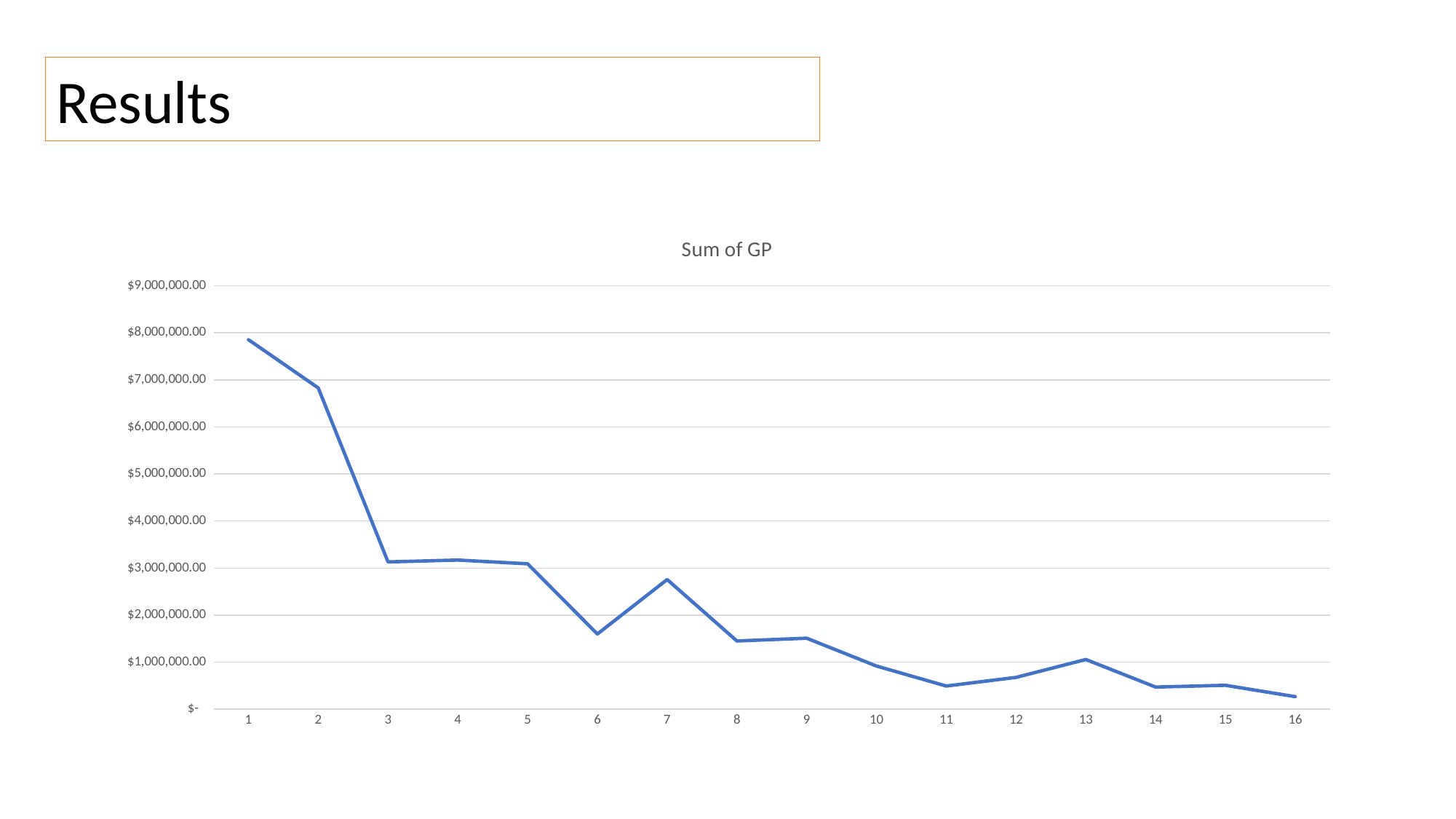
Which has a larger Sum of GP, category 6 or category 7? 7 Is the value for category 1 greater or less than $7,000,000.00? greater How many points are plotted along the x axis of the chart? 16 Which x-axis category has the highest Sum of GP? 1 Which x-axis category has the lowest Sum of GP? 16 Is the value for category 7 greater or less than $2,000,000.00? greater What is the title of the chart? Sum of GP Is the value for category 2 greater or less than $7,000,000.00? less What type of chart is shown on the slide? line chart Overall, do the values rise or fall from category 1 to category 16? fall